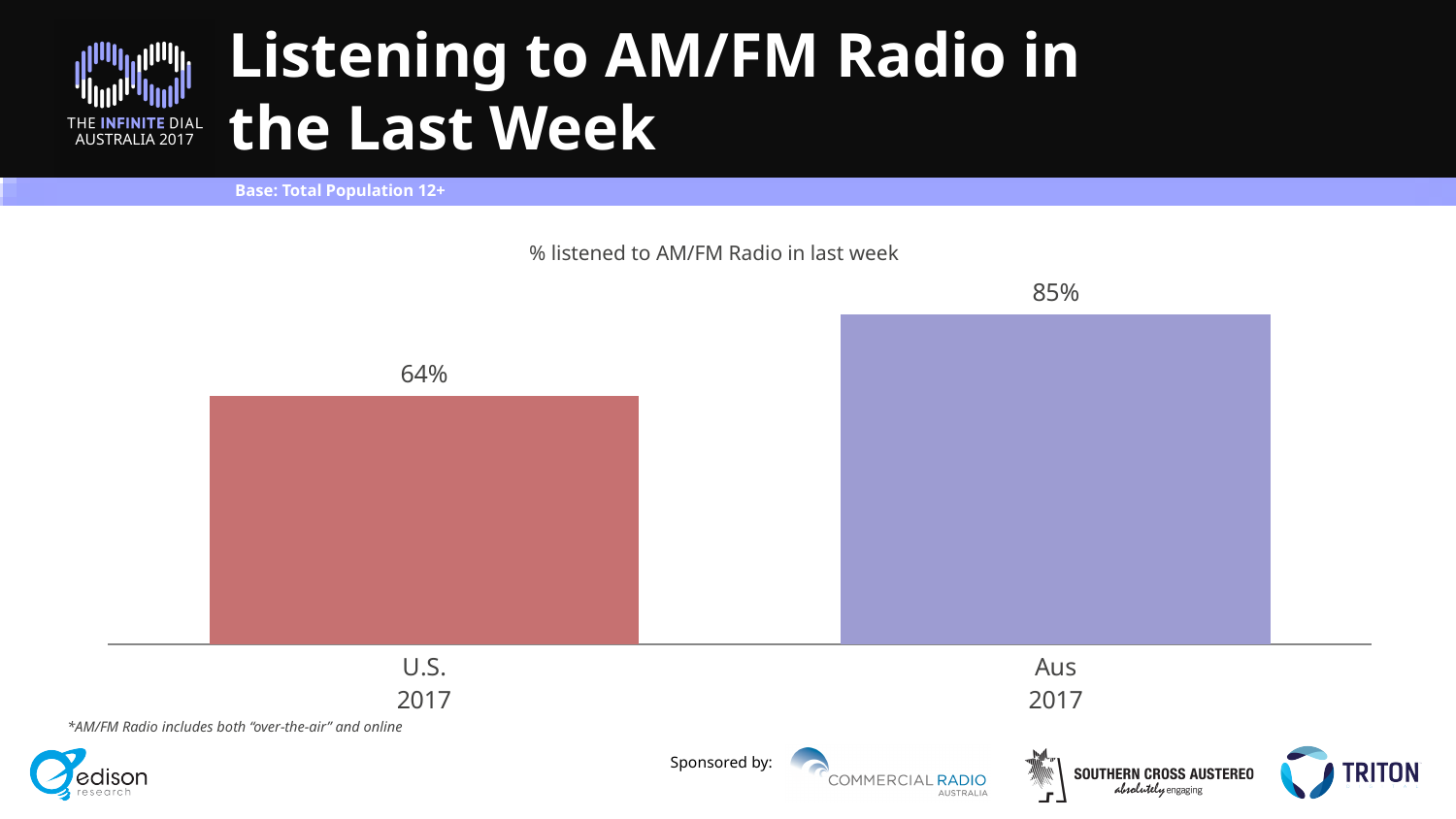
Is the value for Aus 2017 larger than the value for U.S. 2017? Yes What is the difference between the Aus 2017 and U.S. 2017 values? 21% What kind of chart is shown on the slide? Bar chart Which category has the higher value, U.S. 2017 or Aus 2017? Aus 2017 What percentage of the Aus 2017 population listened to AM/FM radio in the last week? 85% Do the values rise or fall from U.S. 2017 to Aus 2017? Rise What is the chart's subtitle describing the measure plotted? % listened to AM/FM Radio in last week How many categories are shown in the chart? 2 Which category has the lower value for listening to AM/FM radio in the last week? U.S. 2017 What colour is the bar for Aus 2017? Purple What percentage of the U.S. 2017 population listened to AM/FM radio in the last week? 64%